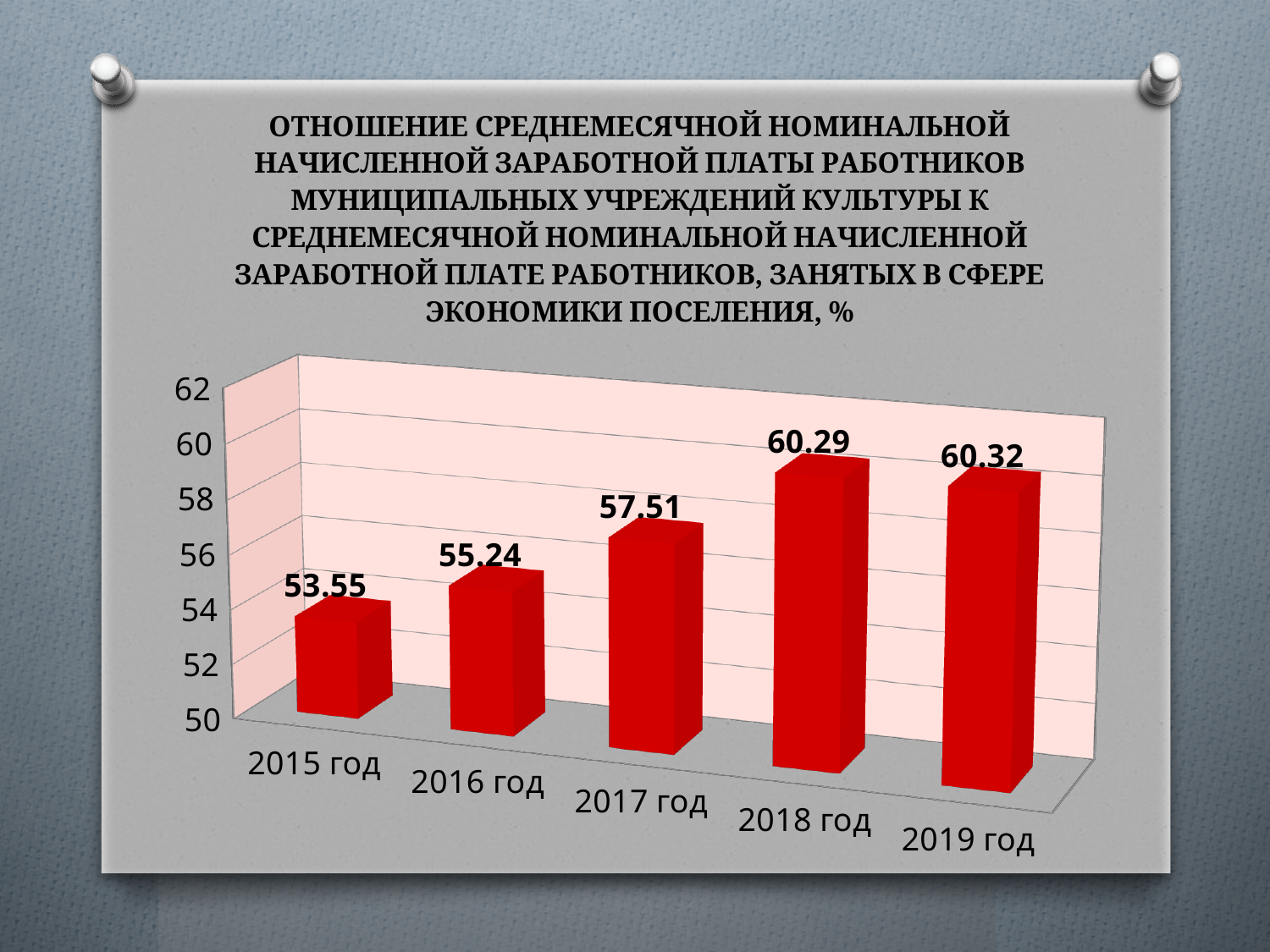
What colour are the bars in the chart? red Which year has the lowest value? 2015 год What is the difference between the values for 2018 год and 2017 год? 2.78 How many years are shown on the x axis? 5 What is the difference between the values for 2016 год and 2015 год? 1.69 Do the values rise or fall from 2015 год to 2019 год? rise What is the value for 2015 год? 53.55 What is the value for 2017 год? 57.51 What kind of chart is shown on the slide? bar chart What is the value for 2019 год? 60.32 Is the value for 2018 год greater or less than 58? greater Which is larger, the value for 2016 год or the value for 2017 год? 2017 год